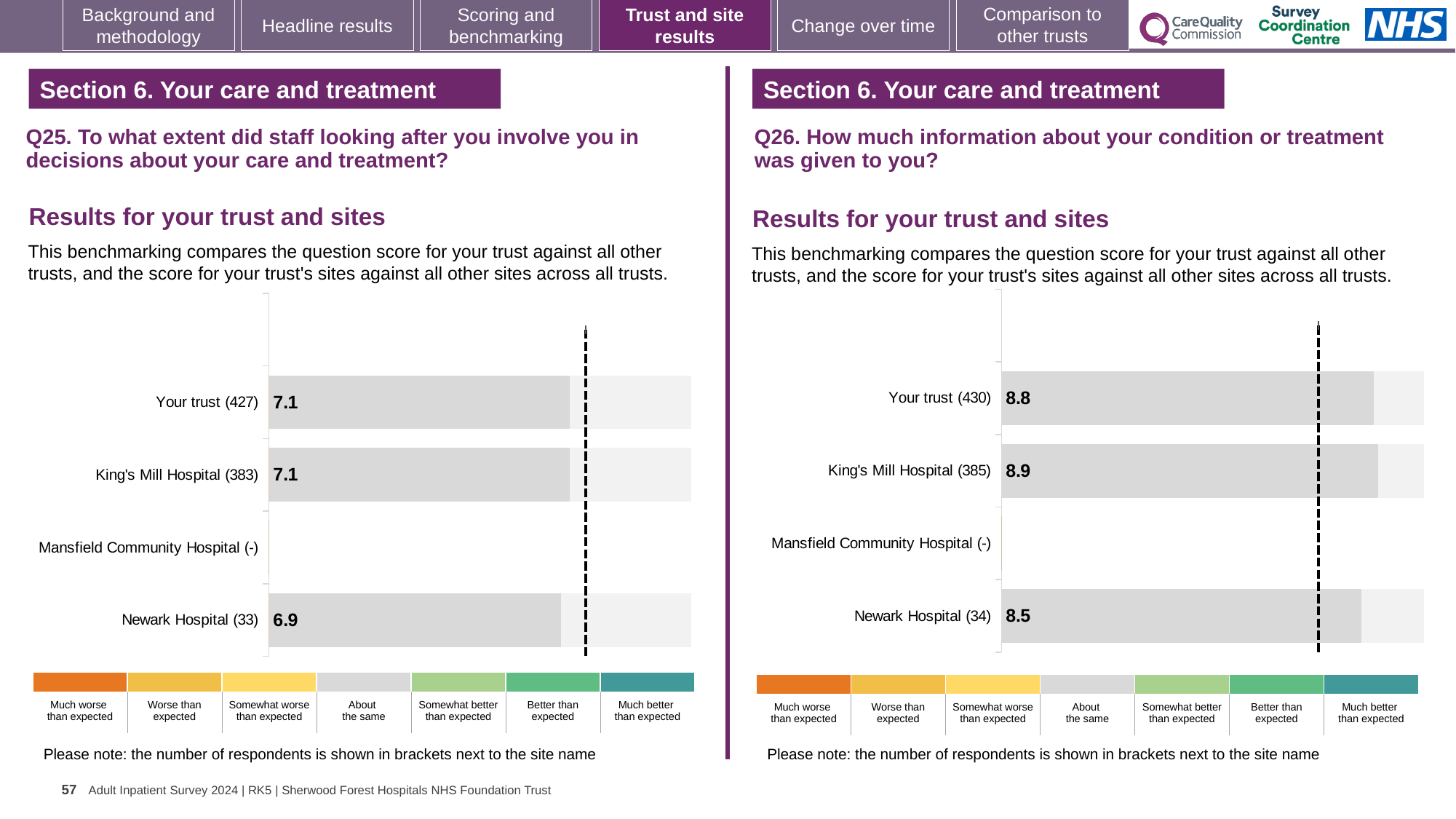
In the Q26 chart on the right, what is the score for King's Mill Hospital? 8.9 In the Q26 chart on the right, which has the larger score, Your trust or King's Mill Hospital? King's Mill Hospital How many categories (trust and sites) are listed in the Q25 chart on the left? 4 In the Q26 chart on the right, how many respondents are shown in brackets for Your trust? 430 In the Q26 chart on the right, which site or trust has the highest score? King's Mill Hospital In the Q25 chart on the left, which site with a score shown has the lowest score? Newark Hospital What type of chart is used in the Q26 chart on the right? Bar chart In the Q26 chart on the right, what is the score for Newark Hospital? 8.5 In the Q26 chart on the right, what is the difference between the scores for King's Mill Hospital and Newark Hospital? 0.4 In the Q25 chart on the left, what is the score for Your trust? 7.1 In the Q25 chart on the left, what is the score for Newark Hospital? 6.9 In the Q25 chart on the left, what is the difference between the scores for Your trust and Newark Hospital? 0.2